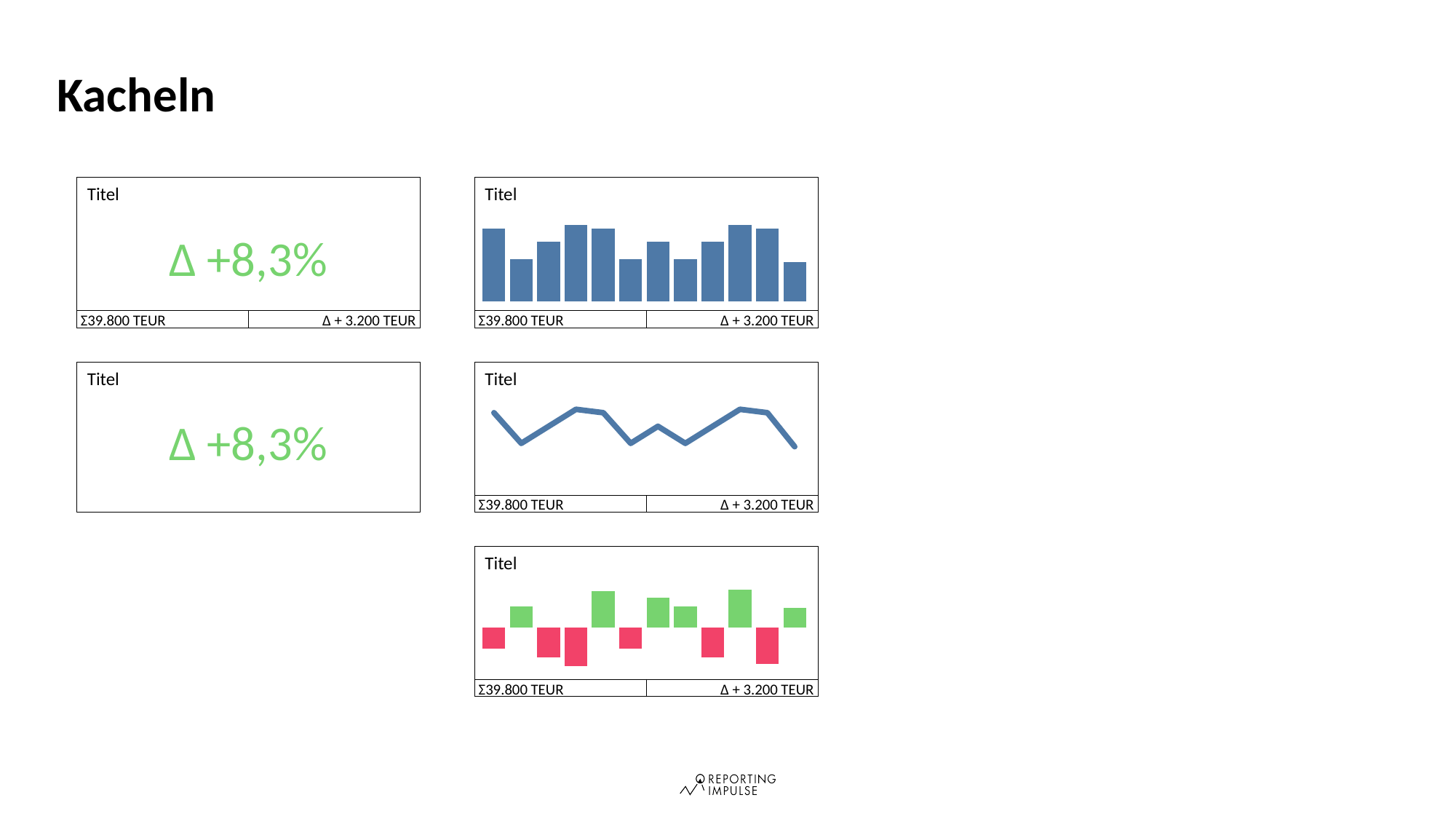
What total value is printed below the bar chart in the top right tile? Σ39.800 TEUR What kind of chart is shown in the top right tile? bar chart In the bottom right tile chart, how many bars are red? 6 In the bottom right tile chart, how many bars are green? 6 In the top right bar chart, which is taller, the first bar or the second bar? the first bar What kind of chart is shown in the middle right tile? line chart In the middle right line chart, does the line rise or fall from the second-to-last point to the last point? fall What colour are the bars in the top right bar chart? blue How many points does the line chart in the middle right tile have? 12 In the middle right line chart, which is higher, the first point or the second point? the first point